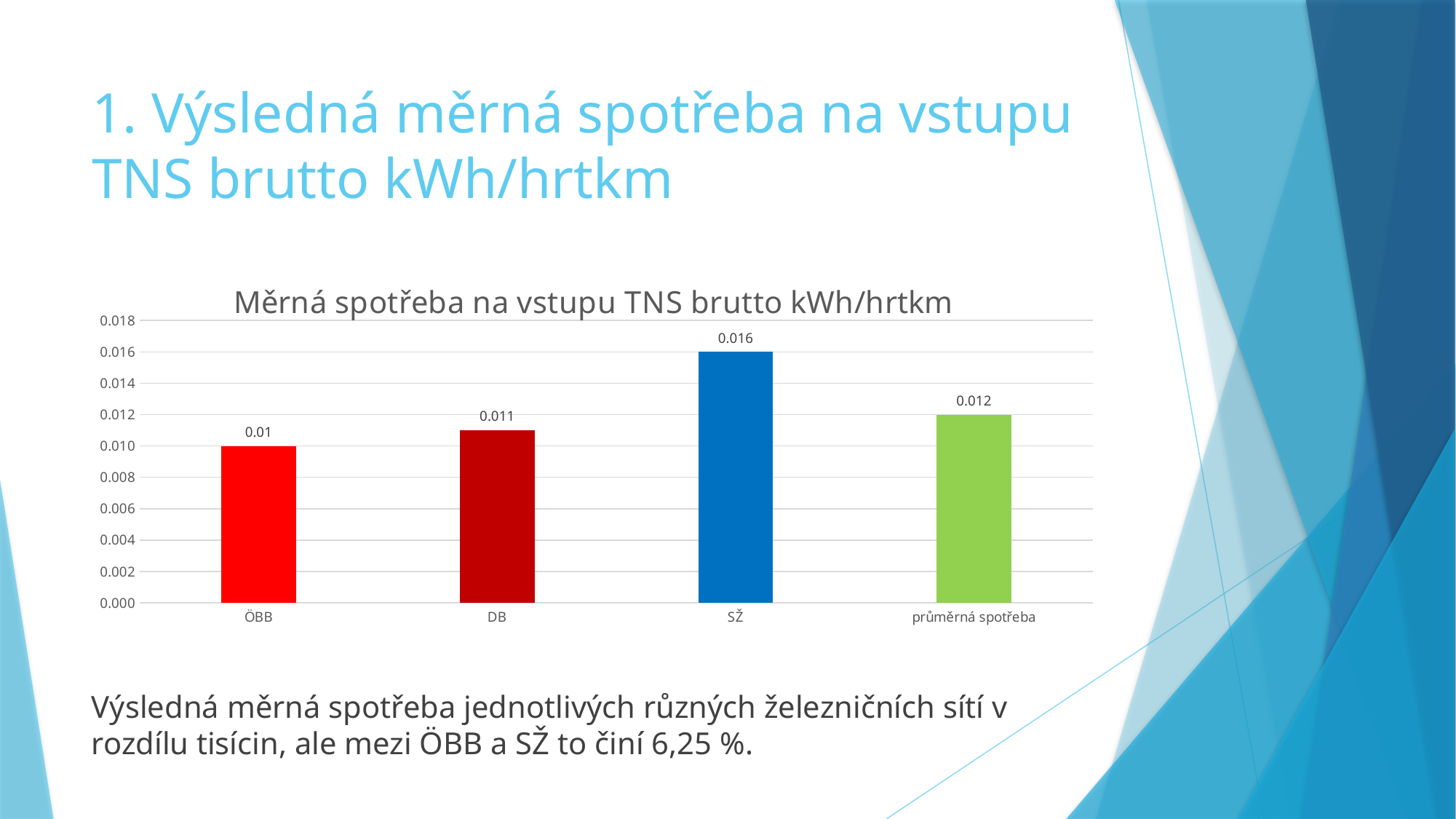
How many categories are shown on the x axis? 4 What kind of chart is shown on the slide? bar chart What is the difference between the values for SŽ and ÖBB? 0.006 What is the value for průměrná spotřeba? 0.012 What is the value for DB? 0.011 What is the value for SŽ? 0.016 What is the value for ÖBB? 0.01 Is the value for SŽ greater or less than 0.014? greater Which category has the lowest value? ÖBB What is the title of the chart? Měrná spotřeba na vstupu TNS brutto kWh/hrtkm Which category has the highest value? SŽ Which is larger, the value for DB or the value for průměrná spotřeba? průměrná spotřeba